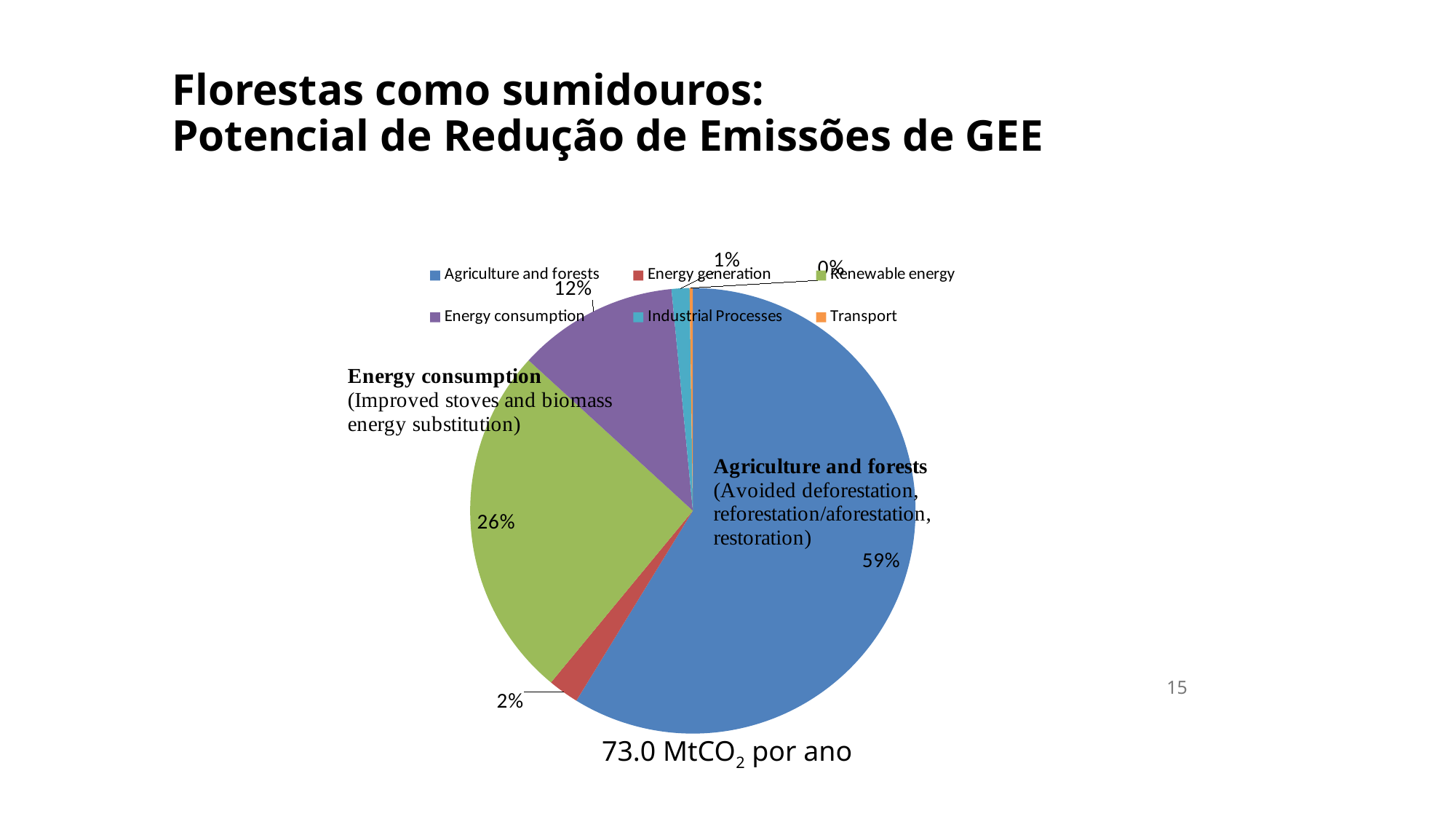
What total annual amount is stated below the pie chart? 73.0 MtCO2 por ano What share of the pie does Energy generation represent? 2% Which is larger, the share for Energy consumption or the share for Renewable energy? Renewable energy What share of the pie does Energy consumption represent? 12% Which category has the smallest slice of the pie? Transport How many categories does the legend list? 6 Which category has the largest slice of the pie? Agriculture and forests What share of the pie does Renewable energy represent? 26% What share of the pie does Industrial Processes represent? 1% What share of the pie does Agriculture and forests represent? 59% What kind of chart is shown on the slide? Pie chart What is the difference in percentage points between Agriculture and forests and Renewable energy? 33